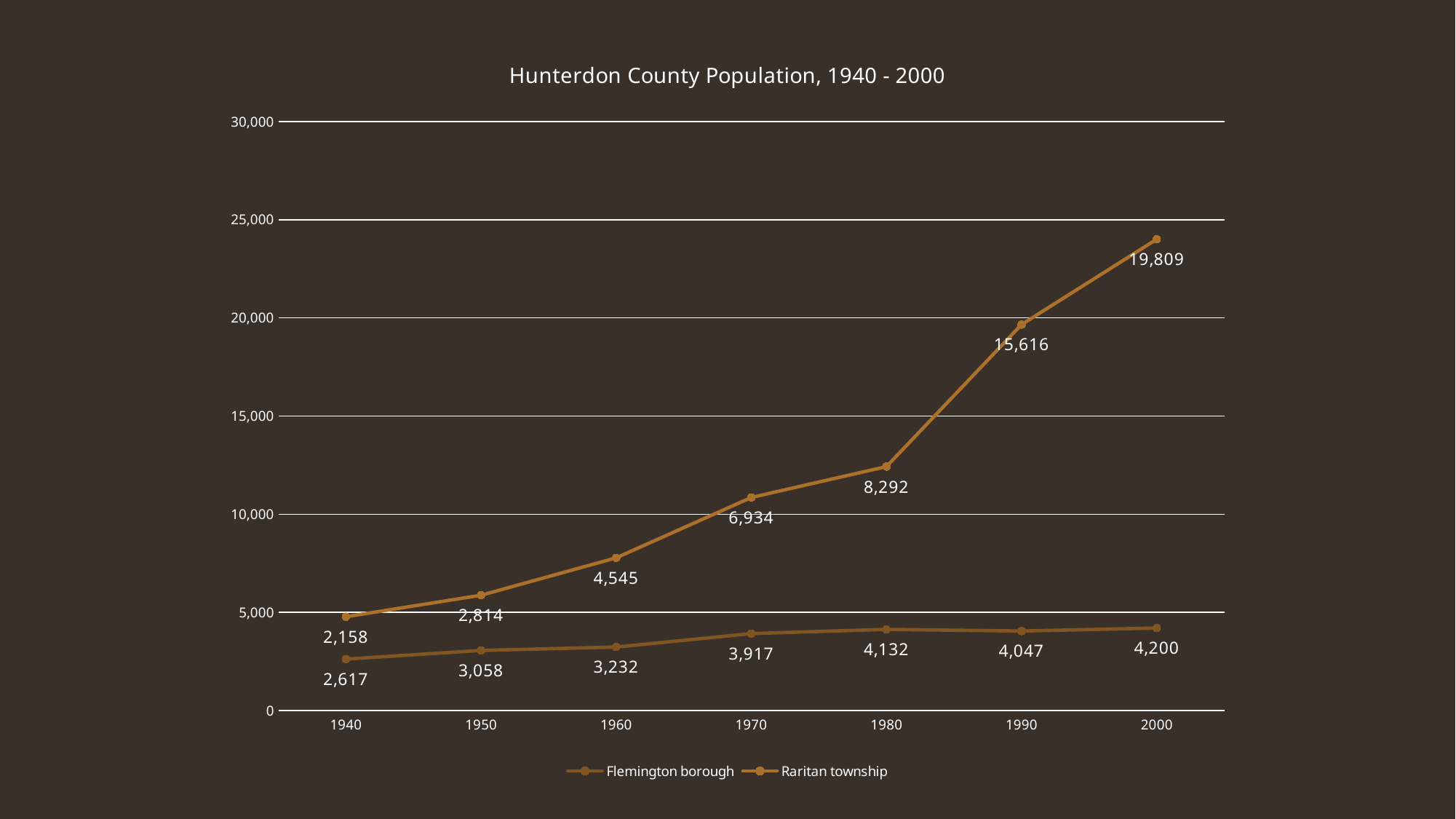
How many series does the legend list? 2 What kind of chart is shown on the slide? Line chart In which year does Raritan township have its highest labelled value? 2000 What is the labelled value for Flemington borough in 1940? 2,617 By how much did the labelled value for Raritan township increase from 1990 to 2000? 4,193 What is the labelled value for Raritan township in 1990? 15,616 How many years are plotted along the x axis? 7 What is the labelled value for Raritan township in 2000? 19,809 What is the title of the chart? Hunterdon County Population, 1940 - 2000 What is the labelled value for Flemington borough in 1980? 4,132 In which year does Flemington borough have its lowest labelled value? 1940 Which is larger in 1970: the labelled value for Raritan township or for Flemington borough? Raritan township